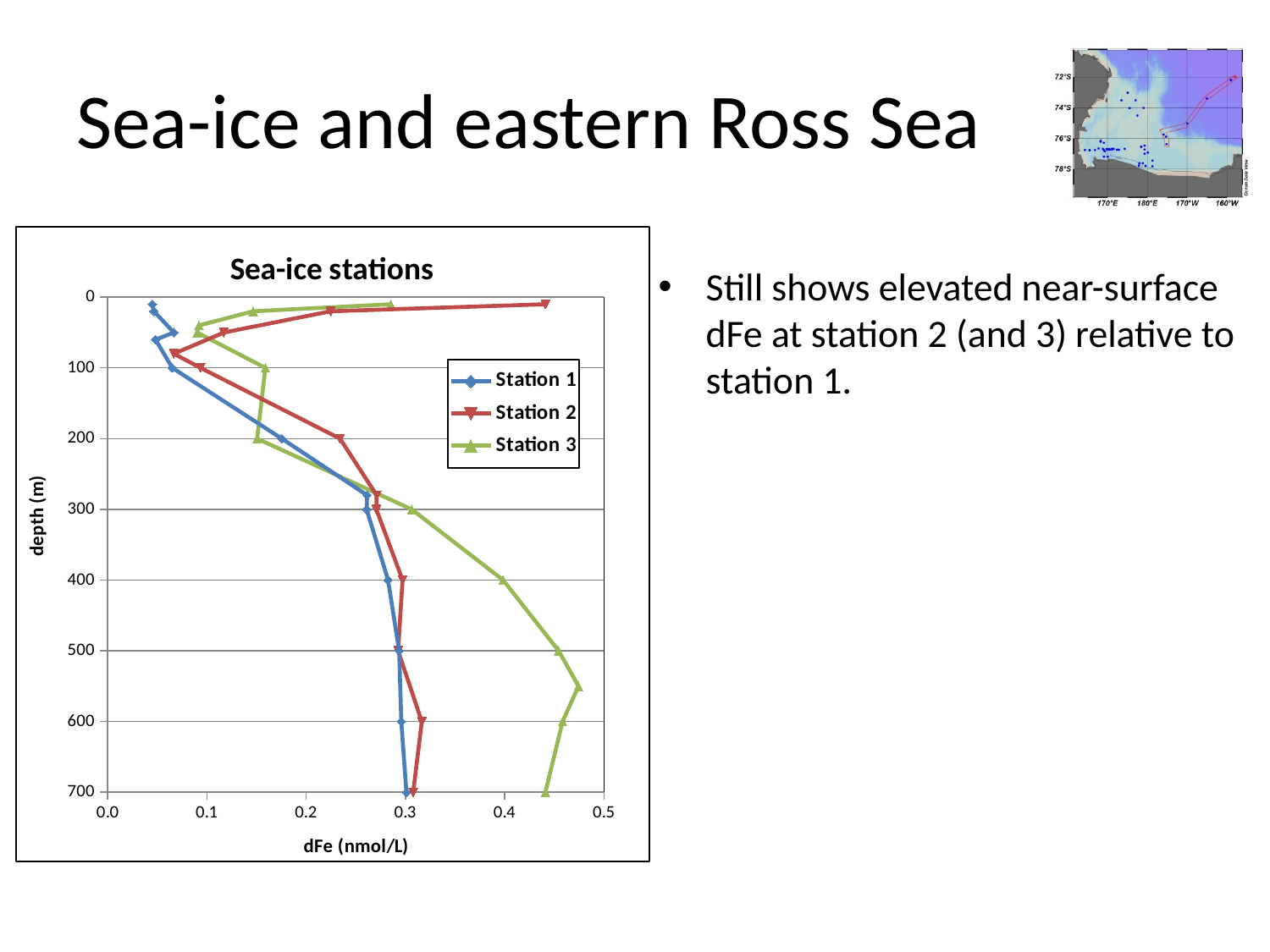
What kind of chart is shown on the slide? line chart Is the dFe value for Station 1 at 100 m depth greater or less than 0.1? less How many series does the legend of the chart list? 3 What is the title of the chart? Sea-ice stations At 500 m depth, which has the higher dFe value, Station 1 or Station 3? Station 3 What is the label of the horizontal axis of the chart? dFe (nmol/L) Is the dFe value for Station 3 at 200 m depth greater or less than 0.2? less At 200 m depth, which has the higher dFe value, Station 2 or Station 3? Station 2 Is the dFe value for Station 2 at 200 m depth greater or less than 0.2? greater Which station has the lowest dFe value at 100 m depth? Station 1 Which station has the highest dFe value at 600 m depth? Station 3